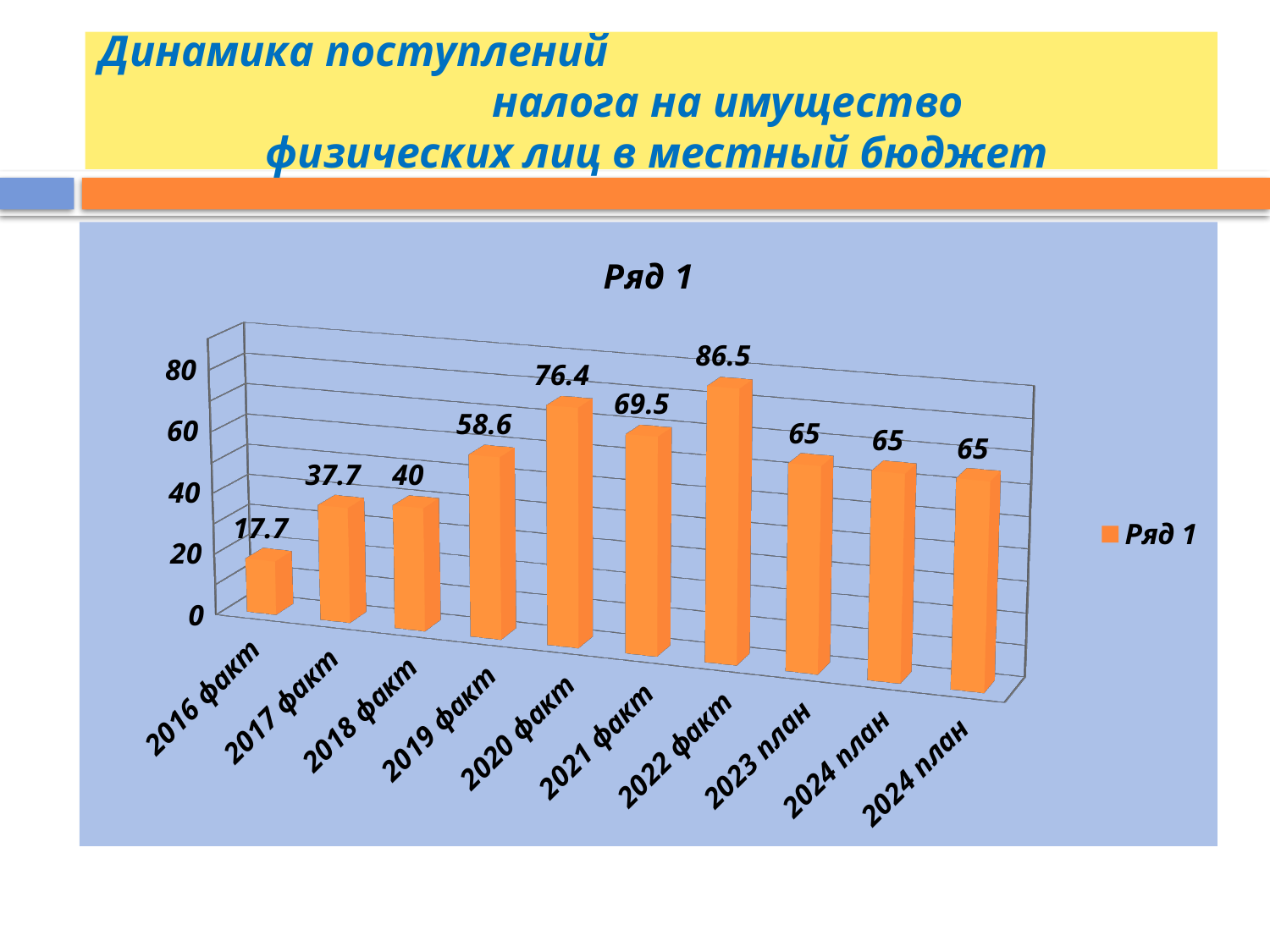
How many bars are shown in the chart? 10 What is the value for 2019 факт? 58.6 Which category has the lowest value? 2016 факт What is the value for 2023 план? 65 What kind of chart is shown on the slide? Bar chart What is the value for 2016 факт? 17.7 What is the difference between the values for 2017 факт and 2016 факт? 20 Which category has the highest value? 2022 факт Which is larger, the value for 2018 факт or the value for 2019 факт? 2019 факт What is the difference between the values for 2020 факт and 2021 факт? 6.9 How many series does the legend list? 1 What is the value for 2022 факт? 86.5